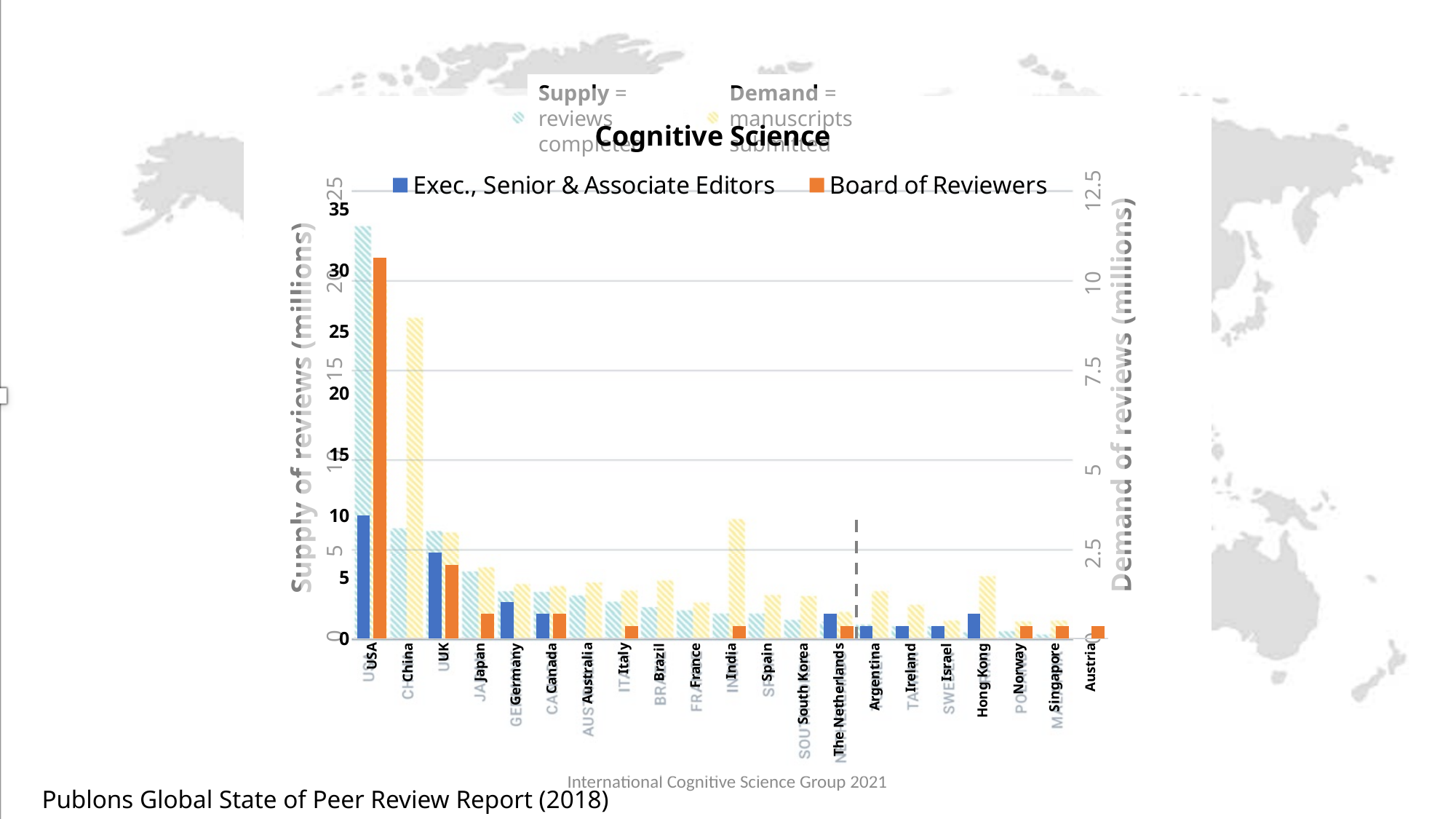
In the Cognitive Science chart, which country has the highest Exec., Senior & Associate Editors value? USA In the Cognitive Science chart, which country has the highest Board of Reviewers value? USA How many series does the legend of the Cognitive Science chart list? 2 How many countries are shown on the x axis of the Cognitive Science chart? 21 What are the two series named in the legend of the Cognitive Science chart? Exec., Senior & Associate Editors; Board of Reviewers In the Cognitive Science chart, which country has a larger Exec., Senior & Associate Editors value: Germany or Canada? Germany What is the title of the bar chart with the blue and orange bars? Cognitive Science In the Cognitive Science chart, is the Exec., Senior & Associate Editors value for USA greater or less than 15? less In the Cognitive Science chart, which is larger for USA: Exec., Senior & Associate Editors or Board of Reviewers? Board of Reviewers What kind of chart is the Cognitive Science chart? bar chart In the Cognitive Science chart, is the Board of Reviewers value for USA greater or less than 25? greater In the Cognitive Science chart, is the Exec., Senior & Associate Editors value for UK greater or less than 10? less